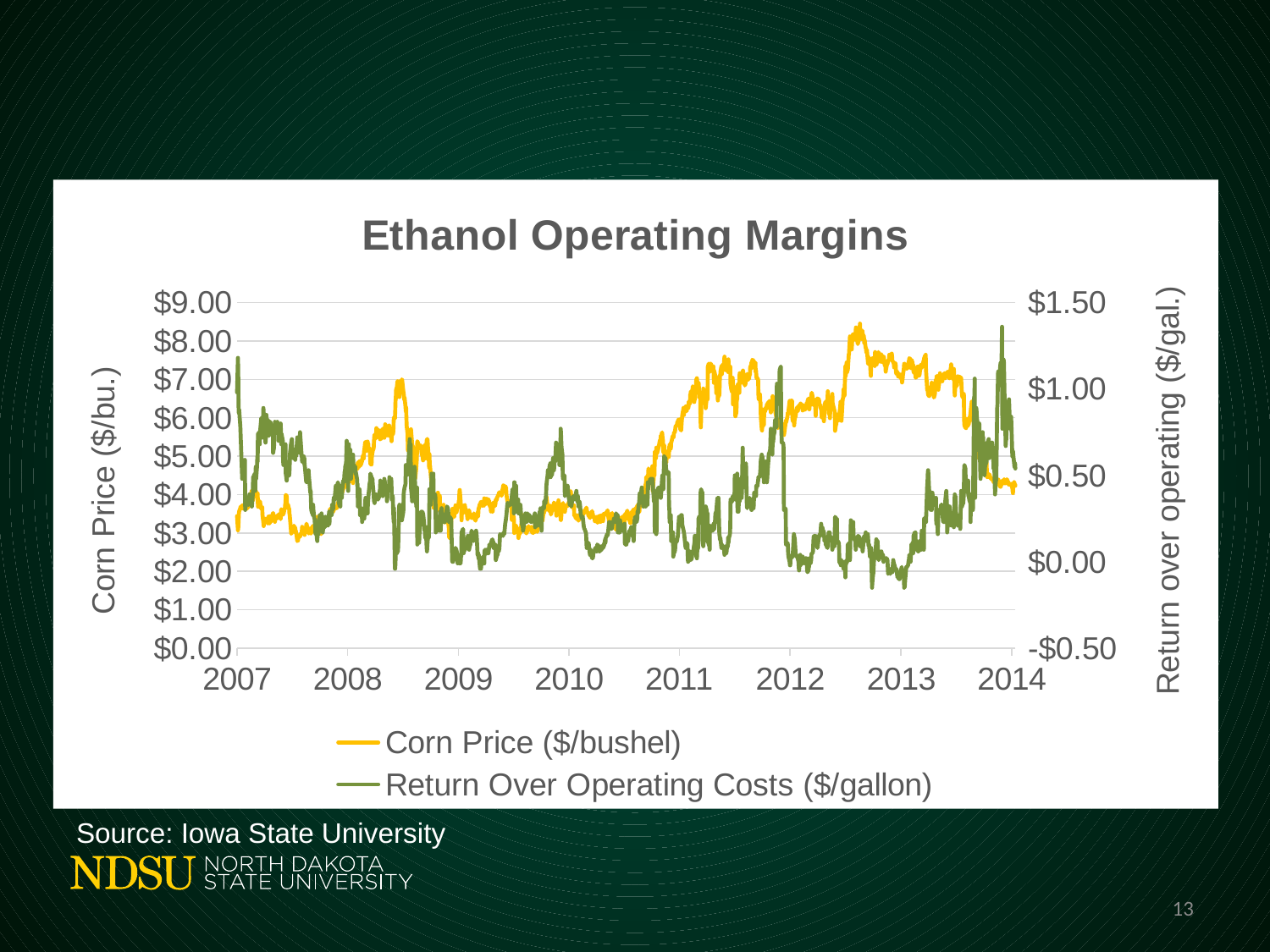
How many series does the legend list? 2 What kind of chart is shown on the slide? Line chart What is the title of the chart? Ethanol Operating Margins Which series is drawn in green? Return Over Operating Costs ($/gallon) How many year labels are shown on the x axis? 8 Is the return over operating costs at the start of 2013 greater or less than $0.50 per gallon? less Is the peak corn price reached in 2012 greater or less than $7.00? greater Does the corn price generally rise or fall from 2010 to 2012? rise Is the corn price in early 2009 greater or less than $5.00? less Does the corn price generally rise or fall from its 2012 peak to 2014? fall